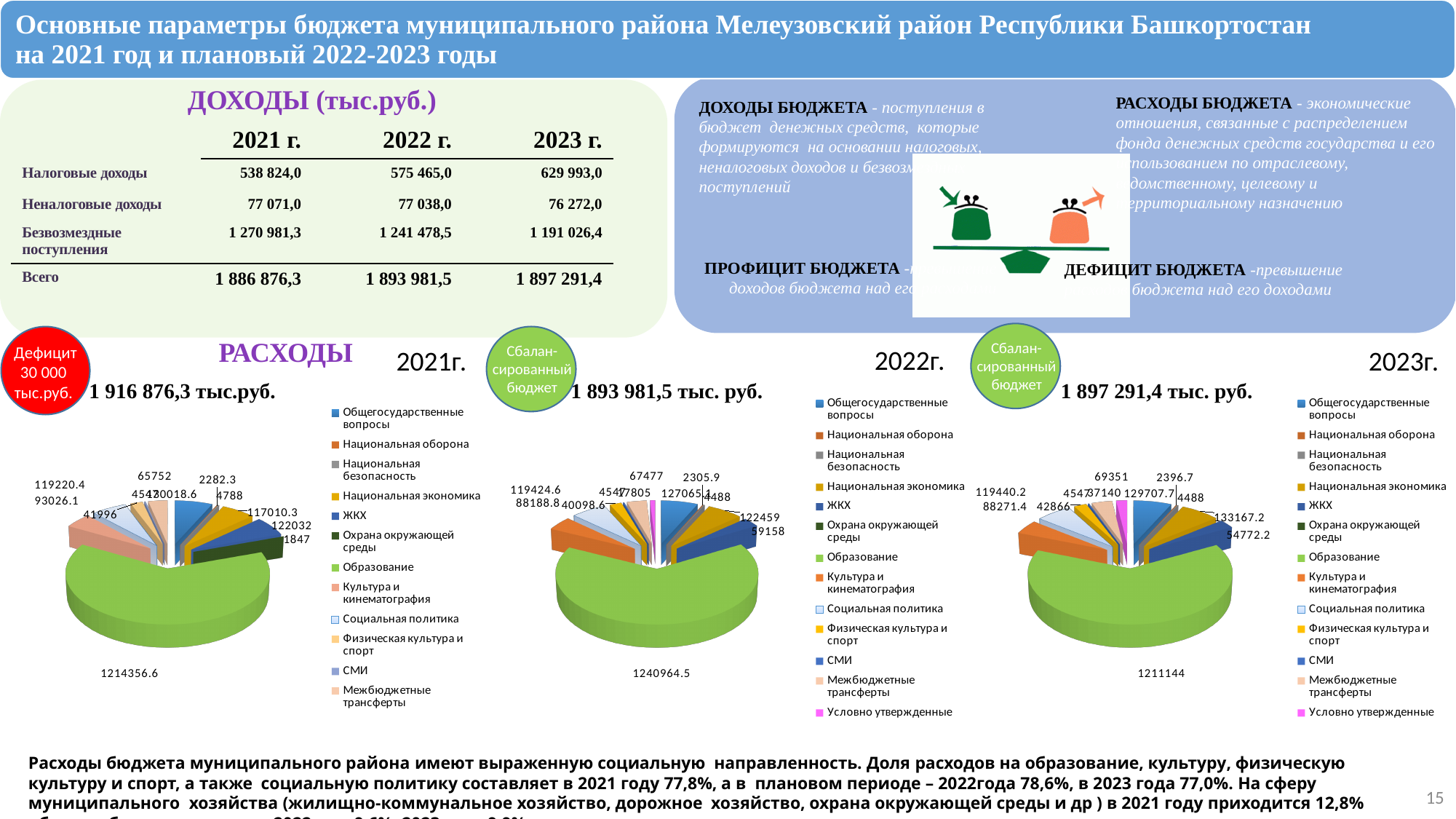
In the 2023 expenditures pie chart, what is the value shown for Образование? 1211144 What kind of chart is used for the 2021 expenditures (РАСХОДЫ 2021г.)? pie chart In the 2021 expenditures pie chart, which category has the largest slice? Образование In the 2022 expenditures pie chart, what is the value shown for Образование? 1240964.5 How many categories does the legend of the 2021 expenditures pie chart list? 12 In the 2021 expenditures pie chart, what is the value shown for Образование? 1214356.6 How many categories does the legend of the 2022 expenditures pie chart list? 13 What total expenditure amount is printed above the 2021 expenditures pie chart? 1 916 876,3 тыс.руб. What is the difference between the Образование value in the 2022 pie chart and the Образование value in the 2021 pie chart? 26607.9 Which legend entry appears in the 2022 and 2023 expenditures pie charts but not in the 2021 chart? Условно утвержденные In the 2023 expenditures pie chart, which category has the largest slice? Образование In the 2021 expenditures pie chart, which is larger: Образование or Национальная оборона? Образование